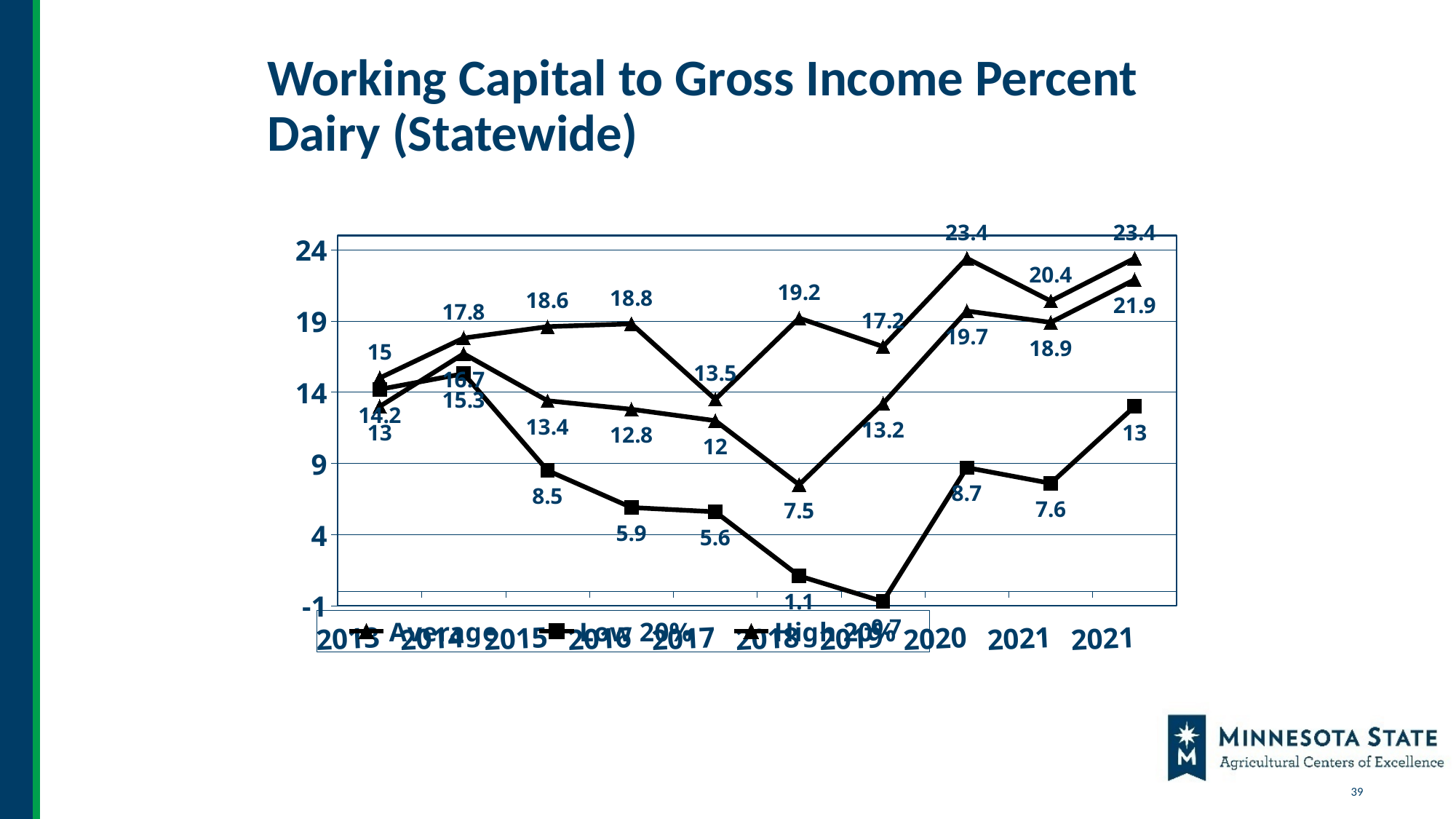
What are the three series named in the legend? Average, Low 20%, High 20% What is the Low 20% value in 2017? 5.6 What is the difference between the High 20% and Average values in 2018? 11.7 What is the High 20% value in 2018? 19.2 What is the Average value in 2019? 13.2 Which year has the larger Average value, 2015 or 2016? 2015 Does the Low 20% series rise or fall from 2015 to 2018? fall What kind of chart is shown on the slide? line chart In which year is the Low 20% series at its lowest? 2019 What is the highest value reached by the High 20% series? 23.4 How many series does the legend list? 3 What is the Average value in 2020? 19.7